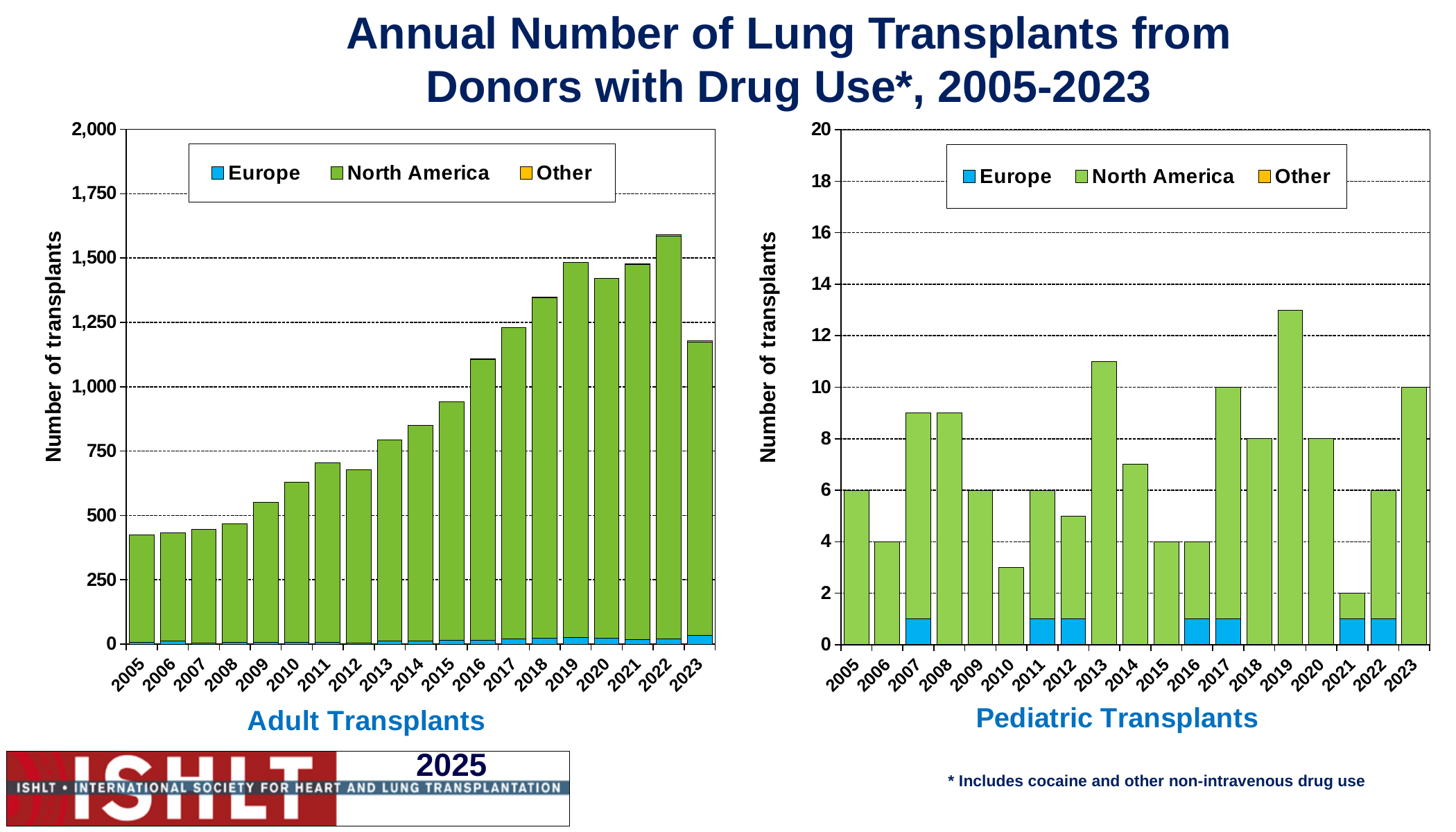
What kind of chart is the Adult Transplants chart on the left? bar chart In the Adult Transplants chart, do the totals generally rise or fall from 2005 to 2022? rise In the Pediatric Transplants chart, what is the total number of transplants in 2021? 2 In the Pediatric Transplants chart, which year has more transplants, 2013 or 2014? 2013 In the Adult Transplants chart, is the total for 2023 greater or less than 1,250? less In the Pediatric Transplants chart, which year has the lowest total number of transplants? 2021 In the Adult Transplants chart, is the total for 2022 greater or less than 1,500? greater In the Adult Transplants chart, which year has the highest total number of transplants? 2022 In the Pediatric Transplants chart, what is the total number of transplants in 2017? 10 How many series does the legend of the Pediatric Transplants chart list? 3 How many years are shown along the x axis of the Adult Transplants chart? 19 In the Pediatric Transplants chart, which year has the highest total number of transplants? 2019